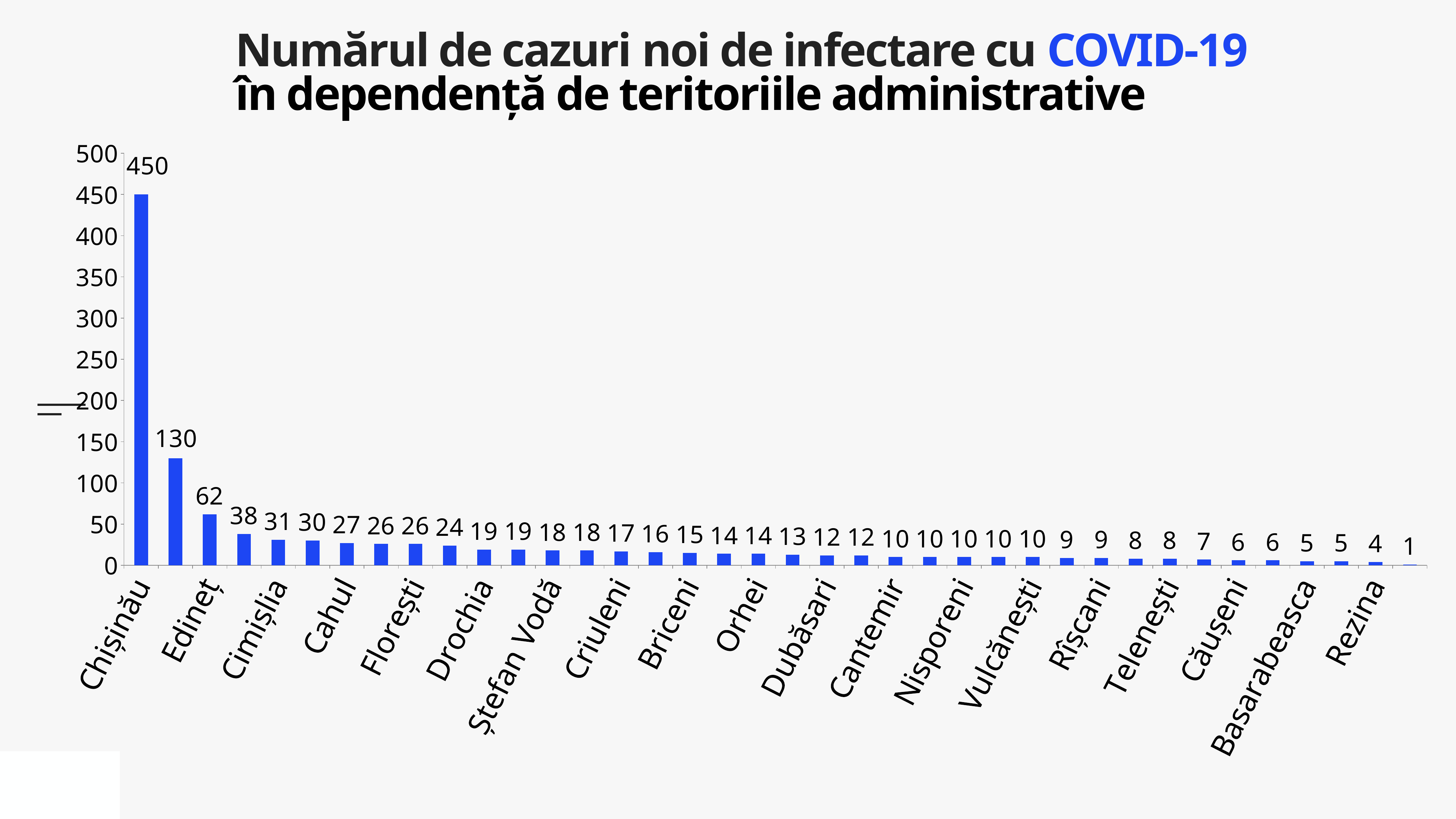
What is the highest tick value shown on the vertical axis? 500 Which has more new cases, Chișinău or Rezina? Chișinău What kind of chart is shown on the slide? bar chart What colour are the bars in the chart? blue What is the largest value labelled on any bar in the chart? 450 Do the bar values rise or fall from left to right along the x axis? fall What is the smallest value labelled on any bar in the chart? 1 What is the number of new cases shown for Chișinău? 450 Which administrative territory has the highest number of new COVID-19 cases? Chișinău Is the value for Chișinău greater or less than 400? greater Is the value for Cahul greater or less than 50? less